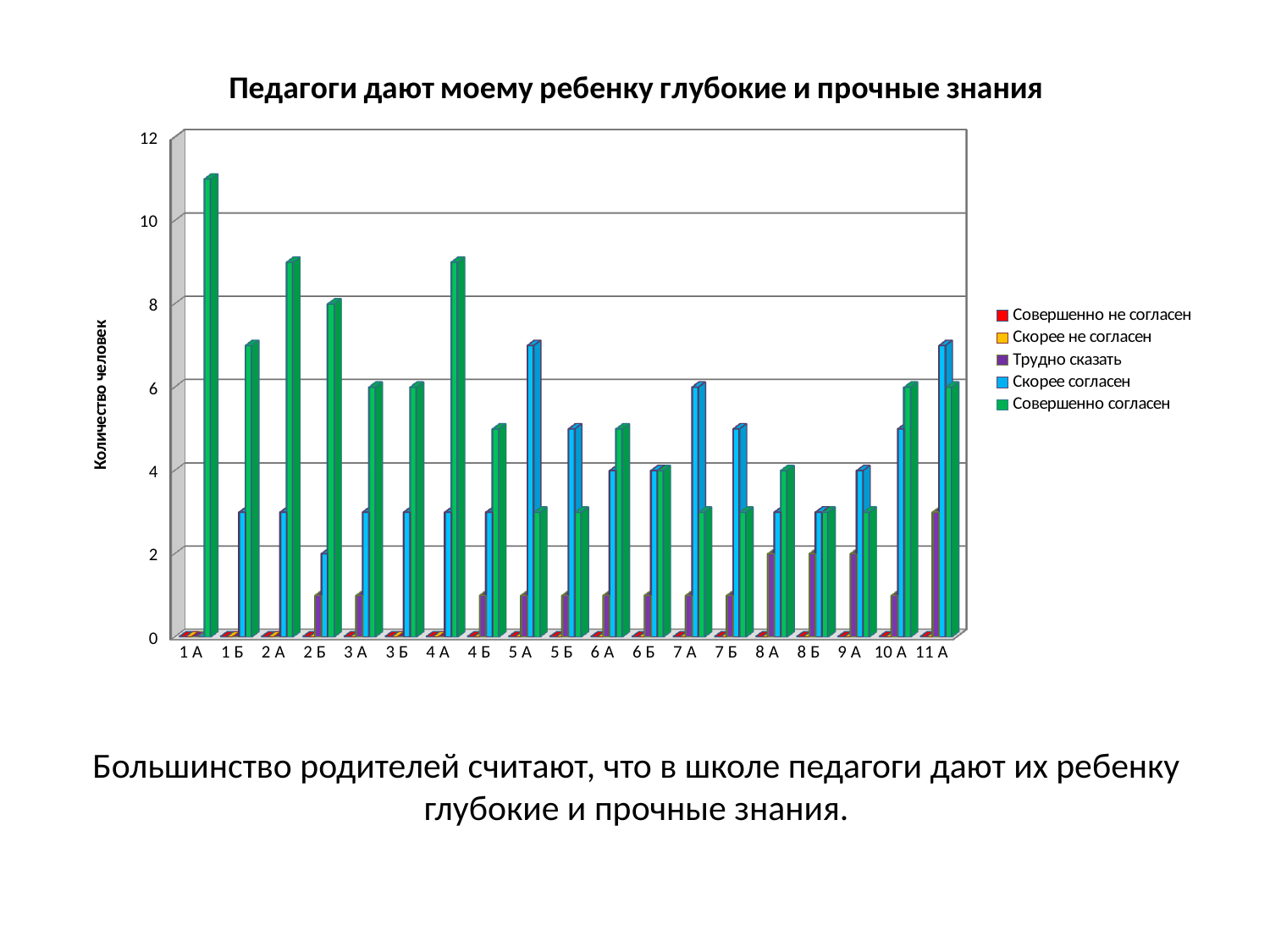
Is the value for 'Совершенно согласен' in class 1 А greater or less than 10? greater What is the label of the vertical axis? Количество человек Is the value for 'Совершенно согласен' in class 8 Б greater or less than 4? less Which class has the highest value for 'Совершенно согласен'? 1 А Is the value for 'Скорее согласен' in class 5 А greater or less than 6? greater What type of chart is shown on the slide? bar chart What is the title of the chart? Педагоги дают моему ребенку глубокие и прочные знания Which is larger for 'Совершенно согласен': class 1 А or class 1 Б? 1 А How many class categories are shown on the x axis? 19 How many series does the legend list? 5 In class 5 А, which series is larger: 'Скорее согласен' or 'Совершенно согласен'? Скорее согласен